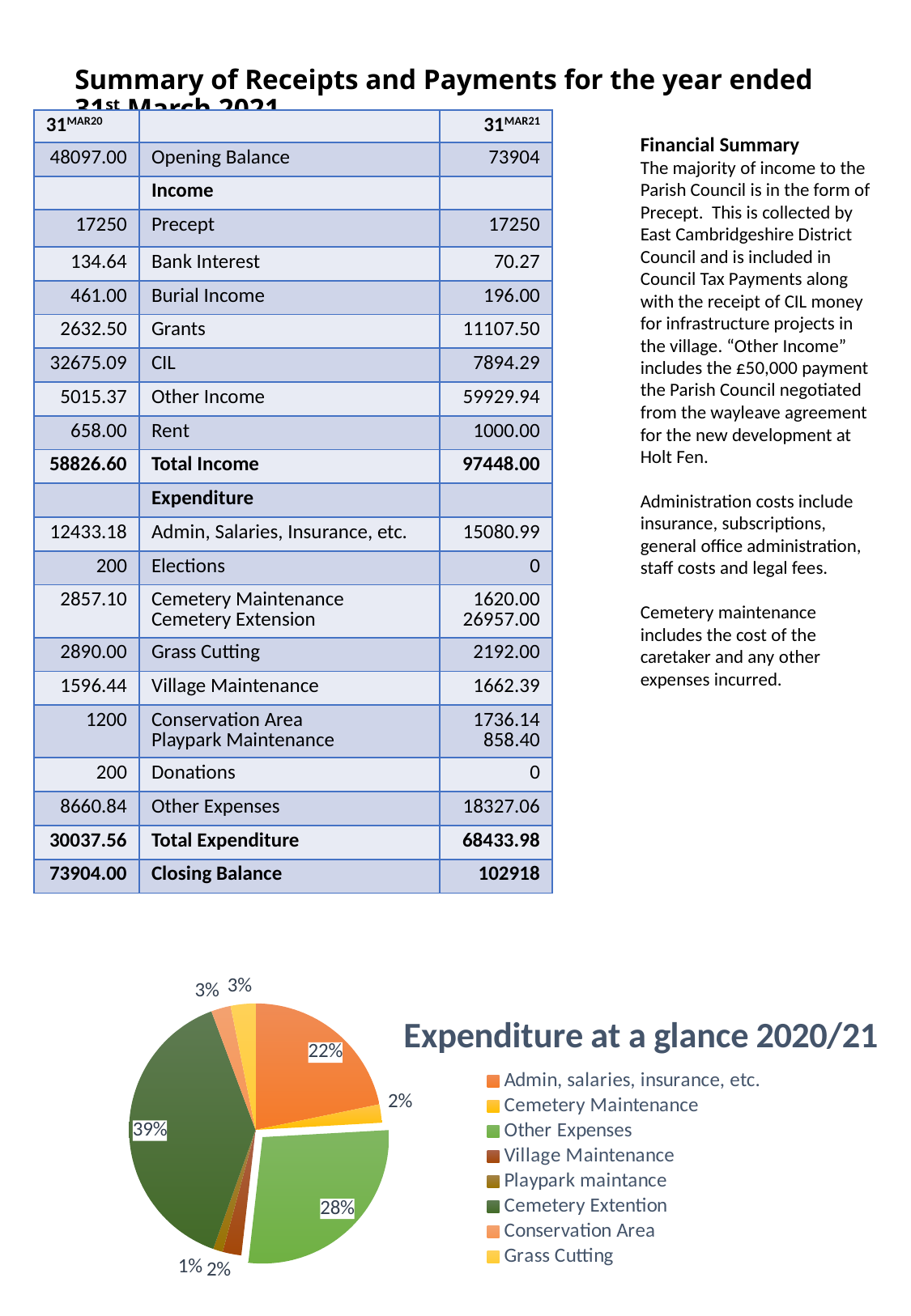
What kind of chart is shown on the slide? pie chart What is the title of the chart on the slide? Expenditure at a glance 2020/21 What is the difference in percentage points between the Cemetery Extention share and the Other Expenses share? 11 What share of the pie does Playpark maintance represent? 1% Which is larger in the pie chart, Other Expenses or Admin, salaries, insurance, etc.? Other Expenses What share of the pie does Cemetery Extention represent? 39% Which category has the smallest share of the pie chart? Playpark maintance What colour is the Cemetery Extention slice in the pie chart? dark green How many entries does the legend of the pie chart list? 8 Which category has the largest share of the pie chart? Cemetery Extention What share of the pie does Other Expenses represent? 28%